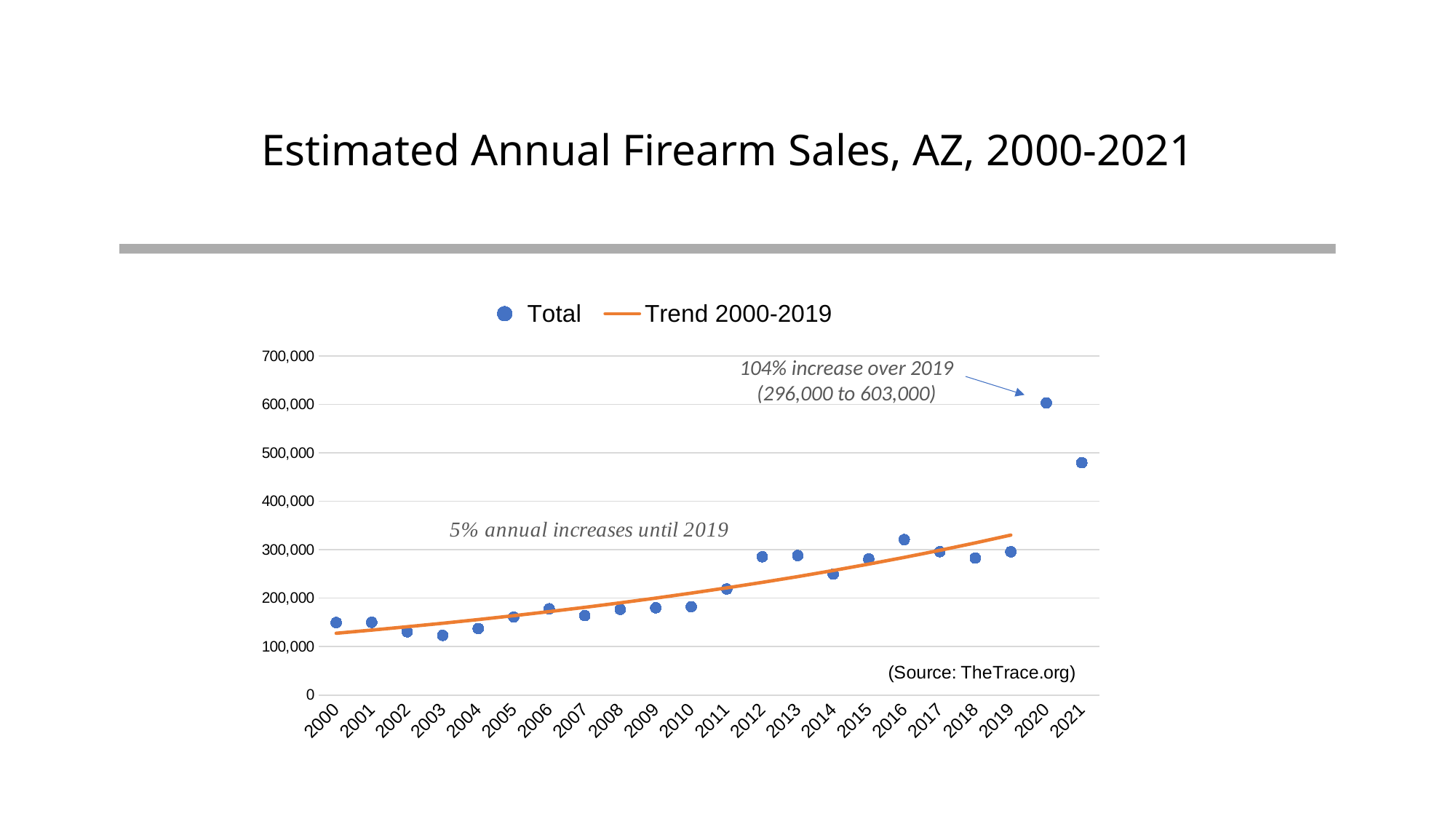
How many series does the legend list? 2 Do the plotted values generally rise or fall from 2000 to 2019? Rise Which year has the highest estimated firearm sales? 2020 What is the difference between the 2020 value (603,000) and the 2019 value (296,000)? 307,000 What kind of chart is shown on the slide? Scatter chart Which year has the larger value, 2020 or 2021? 2020 Is the value for 2014 greater or less than 300,000? less Is the value for 2021 greater or less than 400,000? greater What is the estimated firearm sales value for 2019, as stated in the annotation? 296,000 What is the estimated firearm sales value for 2020, as stated in the annotation? 603,000 How many years are plotted along the x axis? 22 What is the title of the chart? Estimated Annual Firearm Sales, AZ, 2000-2021